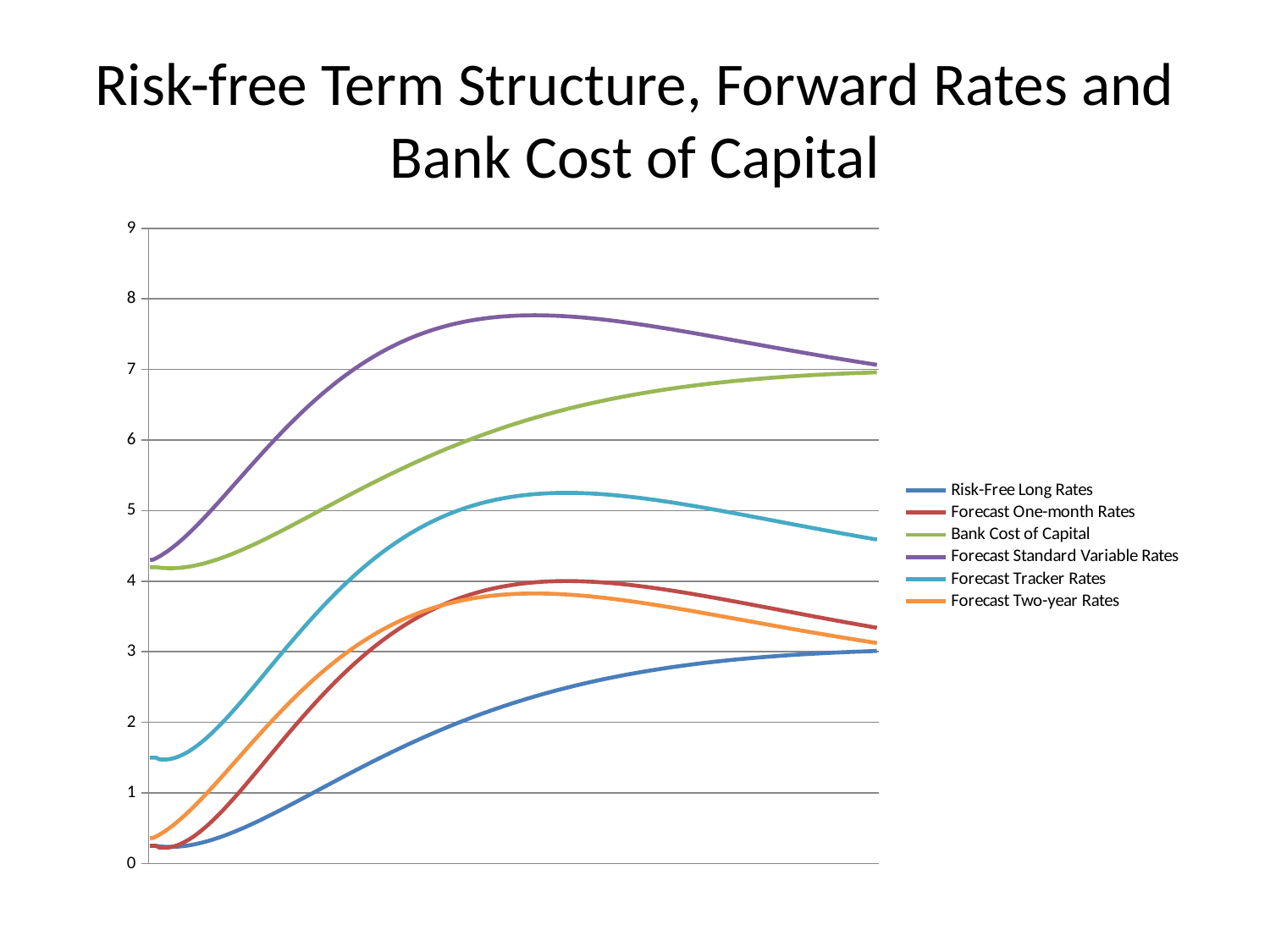
Is the peak value of Forecast Standard Variable Rates greater or less than 7? greater Does the Bank Cost of Capital line rise or fall along the x axis? Rises How many series does the legend list? 6 Is the value of Bank Cost of Capital at the right end of the chart greater or less than 6? greater Is the starting value of Risk-Free Long Rates greater or less than 1? less Which series is plotted highest across the chart? Forecast Standard Variable Rates What is the title of the chart on the slide? Risk-free Term Structure, Forward Rates and Bank Cost of Capital Does the Forecast Standard Variable Rates line rise throughout, or rise and then fall? Rises and then falls What is the highest value shown on the vertical axis? 9 What kind of chart is shown on the slide? Line chart